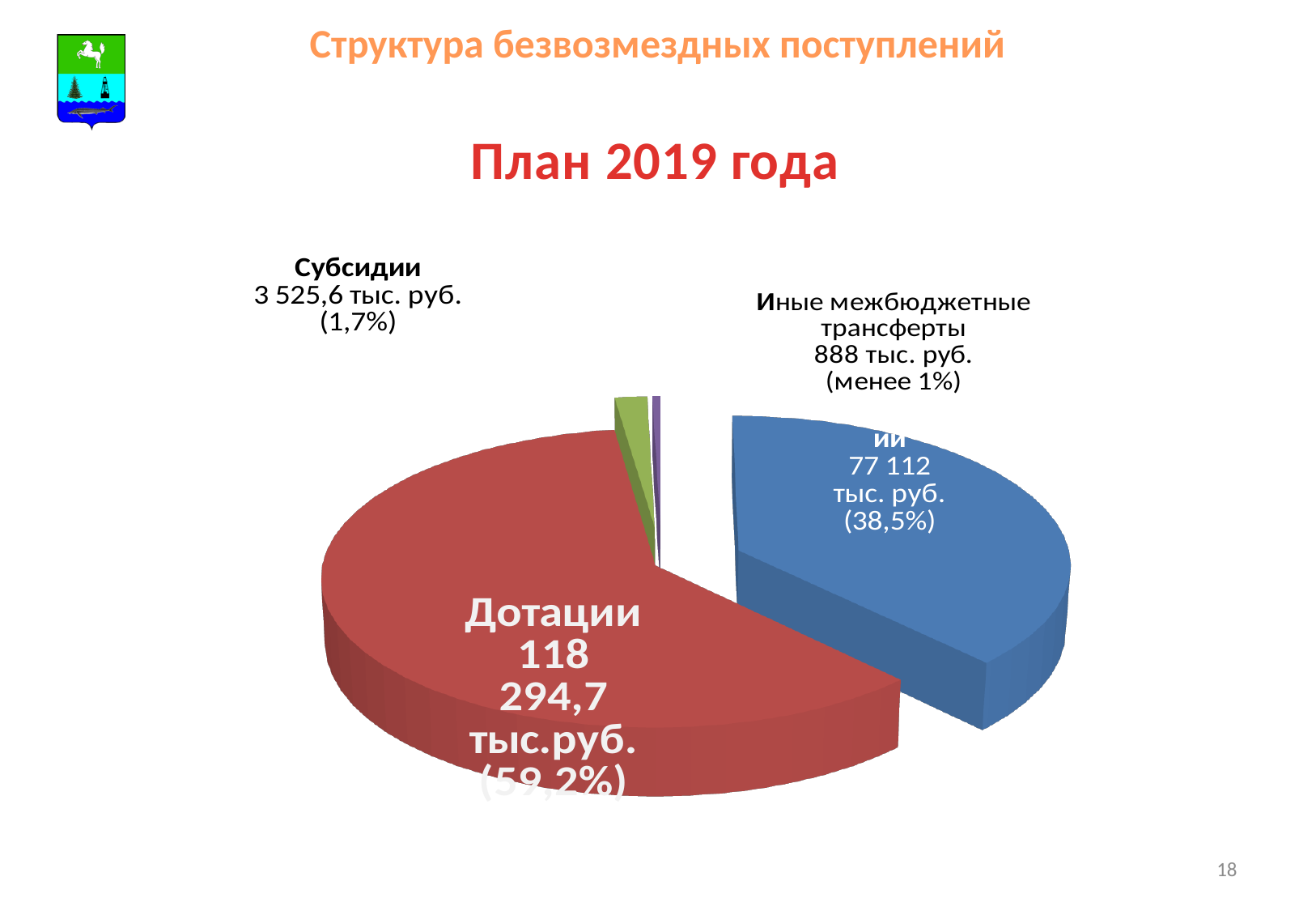
What share of the pie is shown for Иные межбюджетные трансферты? менее 1% What is the value shown for Иные межбюджетные трансферты? 888 тыс. руб. What share of the pie does Дотации represent? 59,2% What percentage is printed on the blue slice of the pie? 38,5% What is the value shown for Субсидии? 3 525,6 тыс. руб. What share of the pie does Субсидии represent? 1,7% Which category has the smallest slice of the pie? Иные межбюджетные трансферты How many slices does the pie chart have? 4 Which is larger, Субсидии or Иные межбюджетные трансферты? Субсидии What type of chart is shown on the slide? pie chart Which category has the largest slice of the pie? Дотации What is the value shown for Дотации? 118 294,7 тыс.руб.